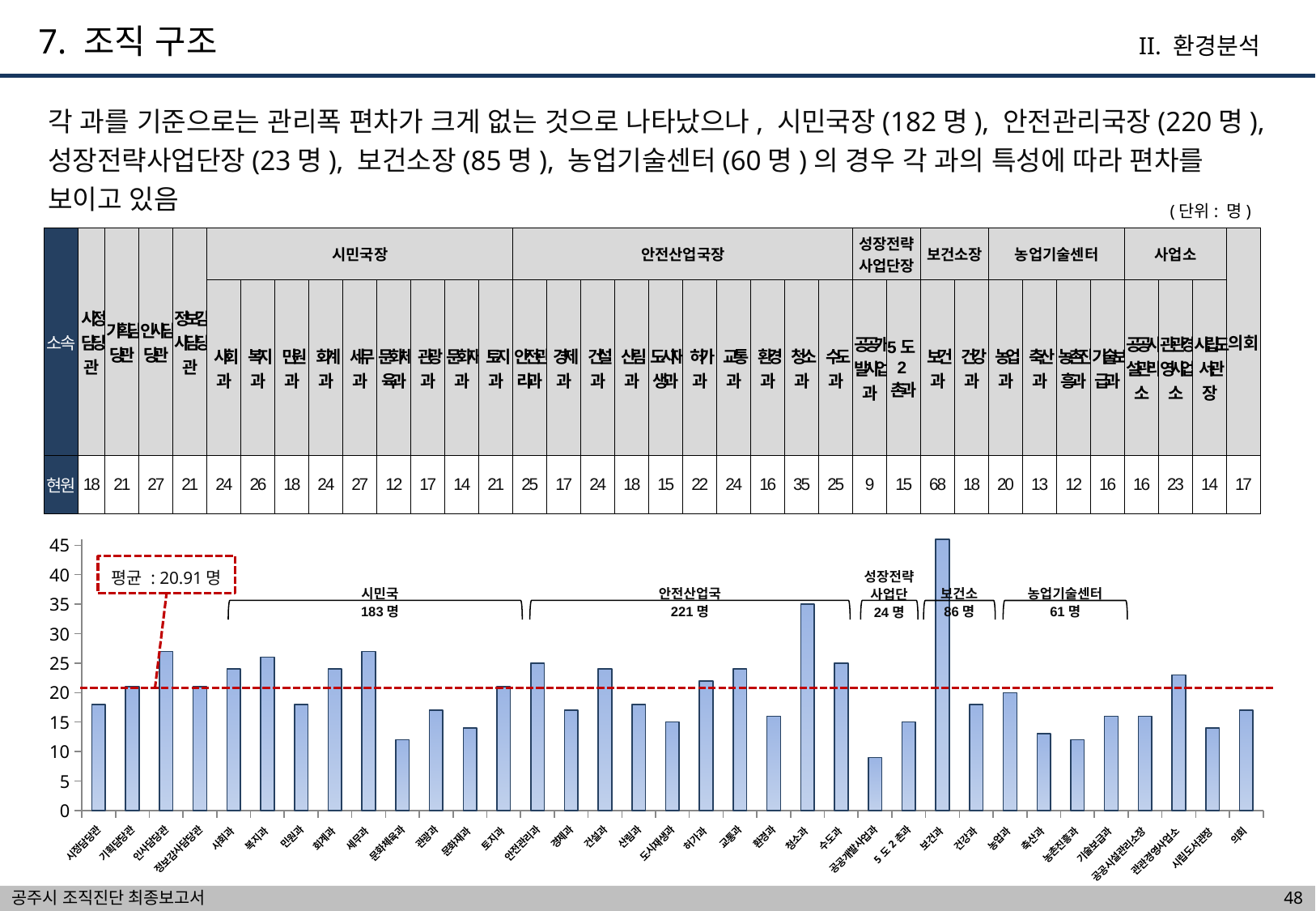
Which is larger, the value for 청소과 or the value for 수도과? 청소과 What average value is shown by the dashed line label in the chart? 20.91 명 Is the value for 보건과 greater or less than 45? greater What is the value for 청소과? 35 What is the difference between the values for 청소과 and 수도과? 10 How many bars are plotted in the chart? 35 Is the value for 문화체육과 greater or less than 15? less What kind of chart is shown on the slide? bar chart Which department has the highest bar in the chart? 보건과 What is the value for 세무과? 27 Which department has the lowest bar in the chart? 공공개발사업과 What is the value for 복지과? 26